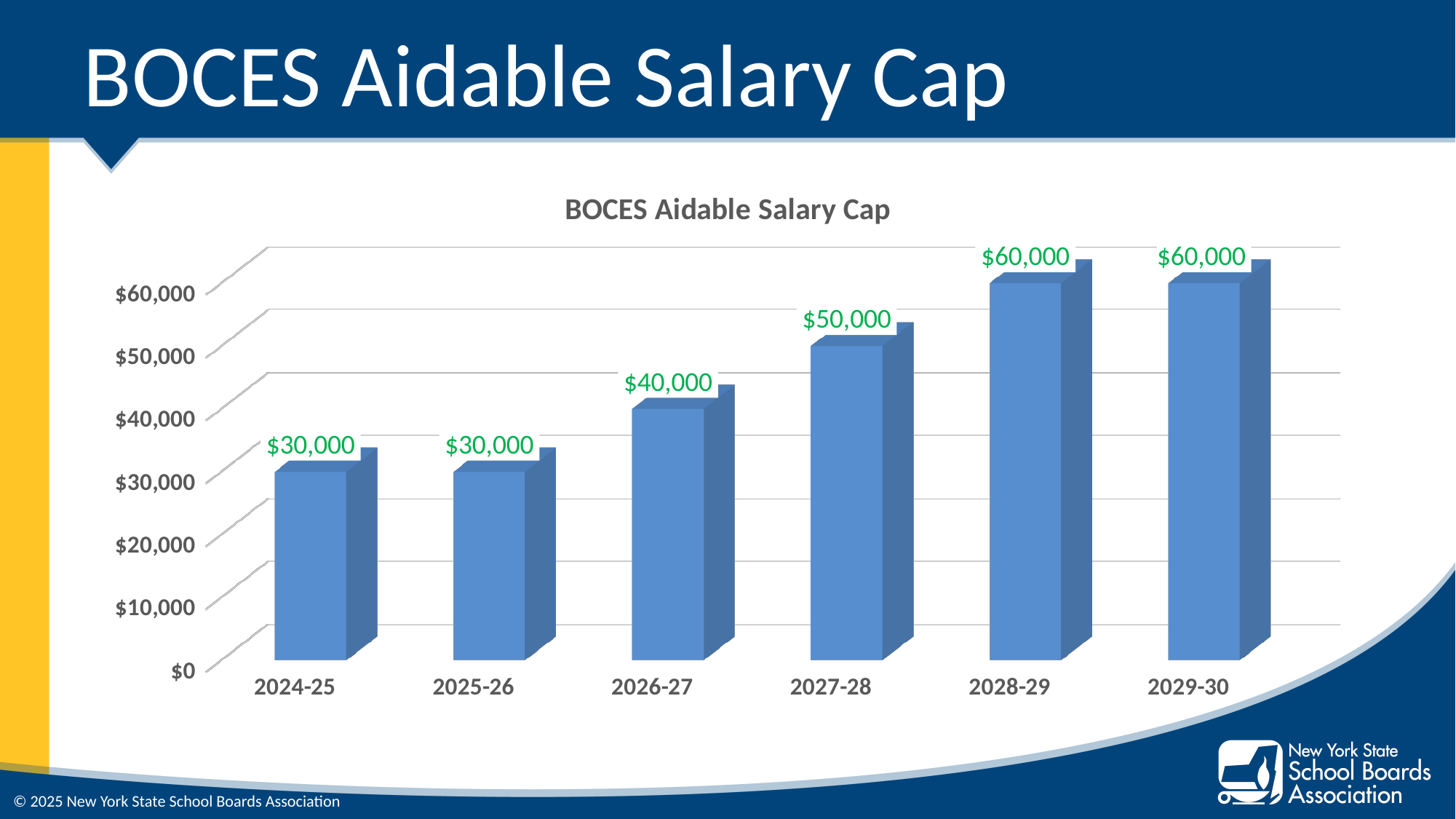
By how much does the salary cap increase from 2026-27 to 2027-28? $10,000 What is the difference between the salary cap in 2028-29 and the salary cap in 2025-26? $30,000 What is the BOCES aidable salary cap for 2029-30? $60,000 What is the BOCES aidable salary cap for 2024-25? $30,000 Do the salary cap values generally rise or fall from 2024-25 to 2029-30? rise Which year has the lowest salary cap shown, 2024-25 or 2026-27? 2024-25 What is the BOCES aidable salary cap for 2026-27? $40,000 Is the salary cap for 2027-28 greater or less than the salary cap for 2026-27? greater How many school years are shown on the x axis of the chart? 6 What kind of chart is shown on the slide? bar chart What is the BOCES aidable salary cap for 2027-28? $50,000 What is the title of the chart? BOCES Aidable Salary Cap